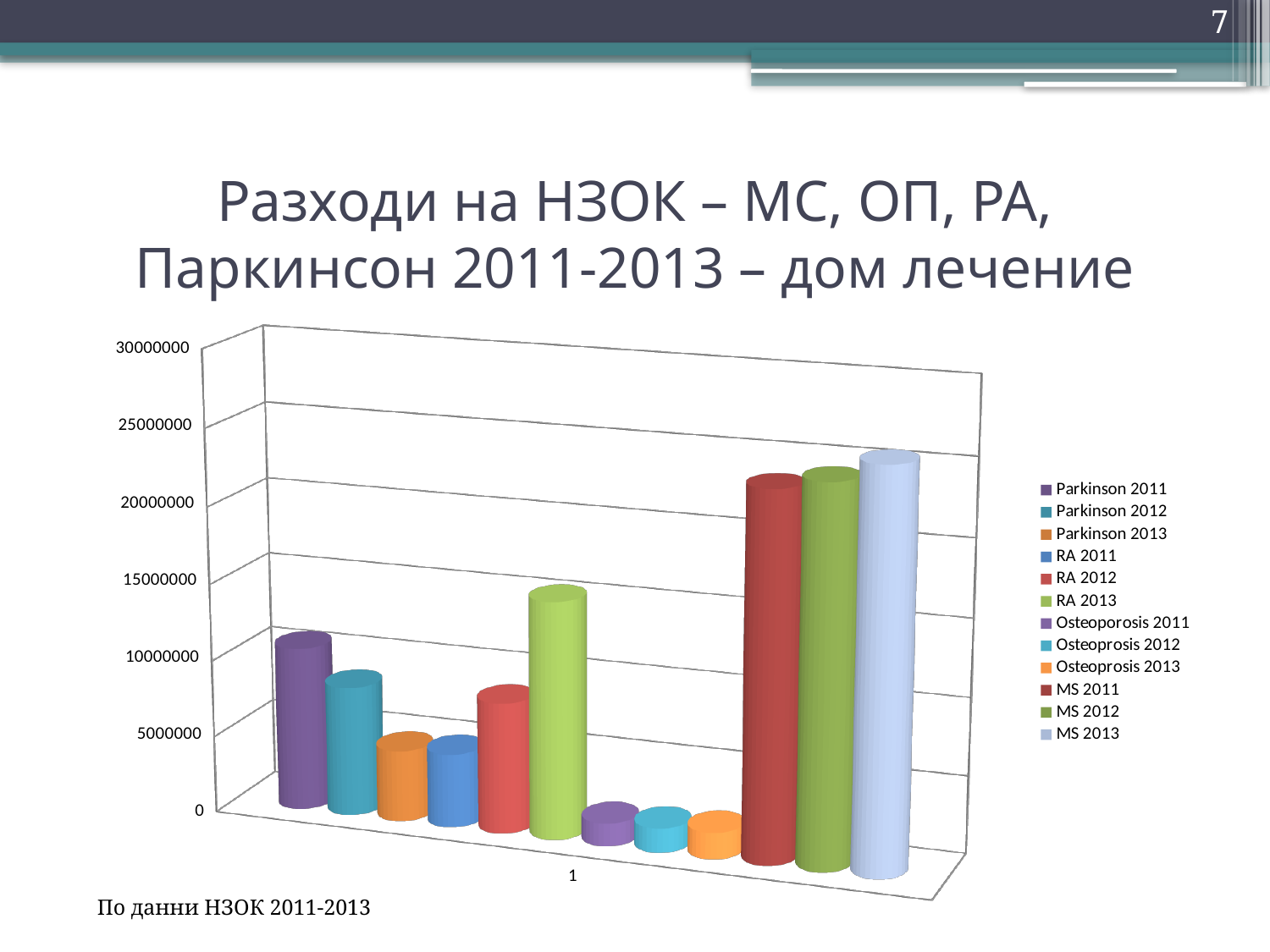
What is the highest value shown on the vertical axis? 30000000 Which is larger, the value for RA 2011 or RA 2013? RA 2013 Is the value for MS 2011 greater or less than 15000000? greater Which is larger, the value for MS 2011 or Osteoprosis 2013? MS 2011 Is the value for RA 2013 greater or less than 10000000? greater What kind of chart is shown on the slide? bar chart Is the value for Osteoporosis 2011 greater or less than 5000000? less Which is larger, the value for Parkinson 2011 or Parkinson 2013? Parkinson 2011 How many categories are shown on the x axis? 1 How many series does the legend list? 12